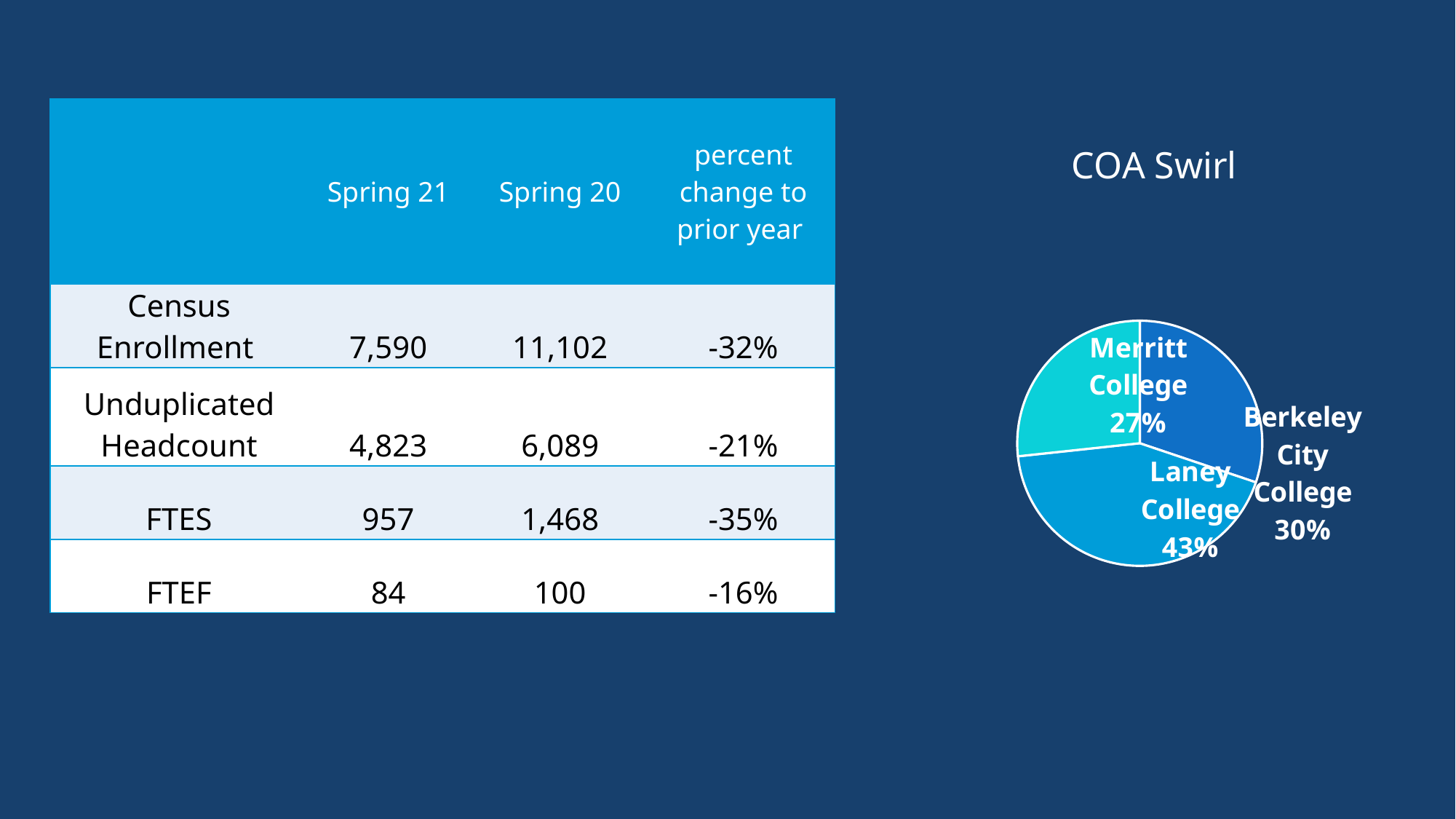
In the COA Swirl pie chart, what share does Laney College have? 43% In the COA Swirl pie chart, is the share for Laney College greater or less than 40%? greater In the COA Swirl pie chart, what is the difference in percentage points between Berkeley City College and Merritt College? 3 In the COA Swirl pie chart, which college has the largest slice? Laney College What is the title of the pie chart on the slide? COA Swirl In the COA Swirl pie chart, what is the difference in percentage points between Laney College and Merritt College? 16 In the COA Swirl pie chart, what share does Merritt College have? 27% In the COA Swirl pie chart, which is larger, the share for Berkeley City College or the share for Laney College? Laney College What type of chart is the COA Swirl chart? pie chart In the COA Swirl pie chart, which college has the smallest slice? Merritt College In the COA Swirl pie chart, what share does Berkeley City College have? 30% In the COA Swirl pie chart, how many slices are there? 3